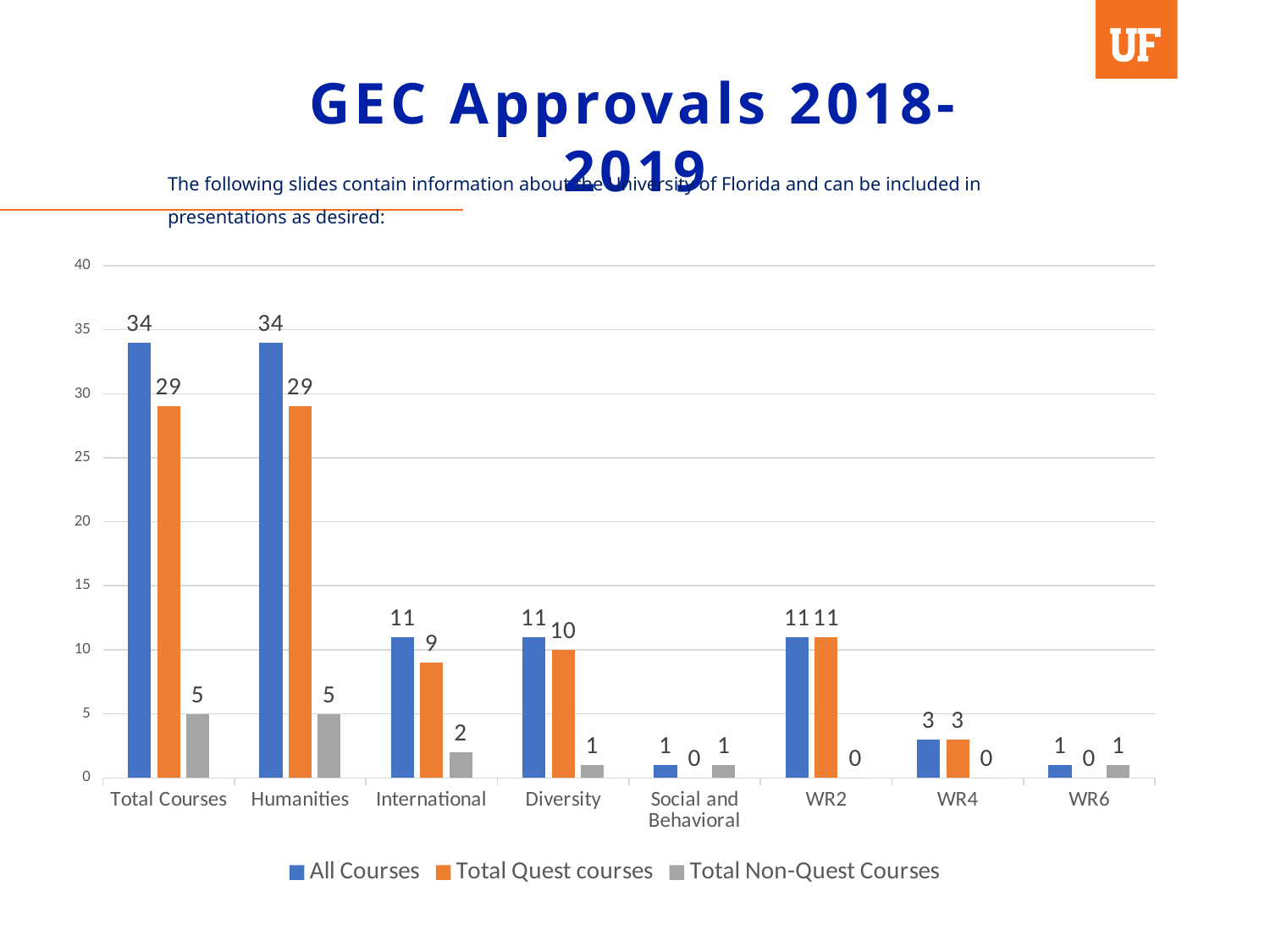
What is the value for All Courses in the Humanities category? 34 What is the value for Total Quest courses in the WR2 category? 11 What is the difference between Total Quest courses in Humanities and Total Quest courses in Diversity? 19 What is the difference between All Courses and Total Quest courses in the Total Courses category? 5 What kind of chart is shown on the slide? Bar chart What is the value for Total Non-Quest Courses in the Diversity category? 1 Which is larger in the Diversity category: All Courses or Total Quest courses? All Courses Which series is shown in orange in the legend? Total Quest courses Which category has the lowest value for All Courses? Social and Behavioral and WR6 (both 1) What is the value for Total Quest courses in the International category? 9 How many categories are shown on the x axis? 8 How many series does the legend list? 3